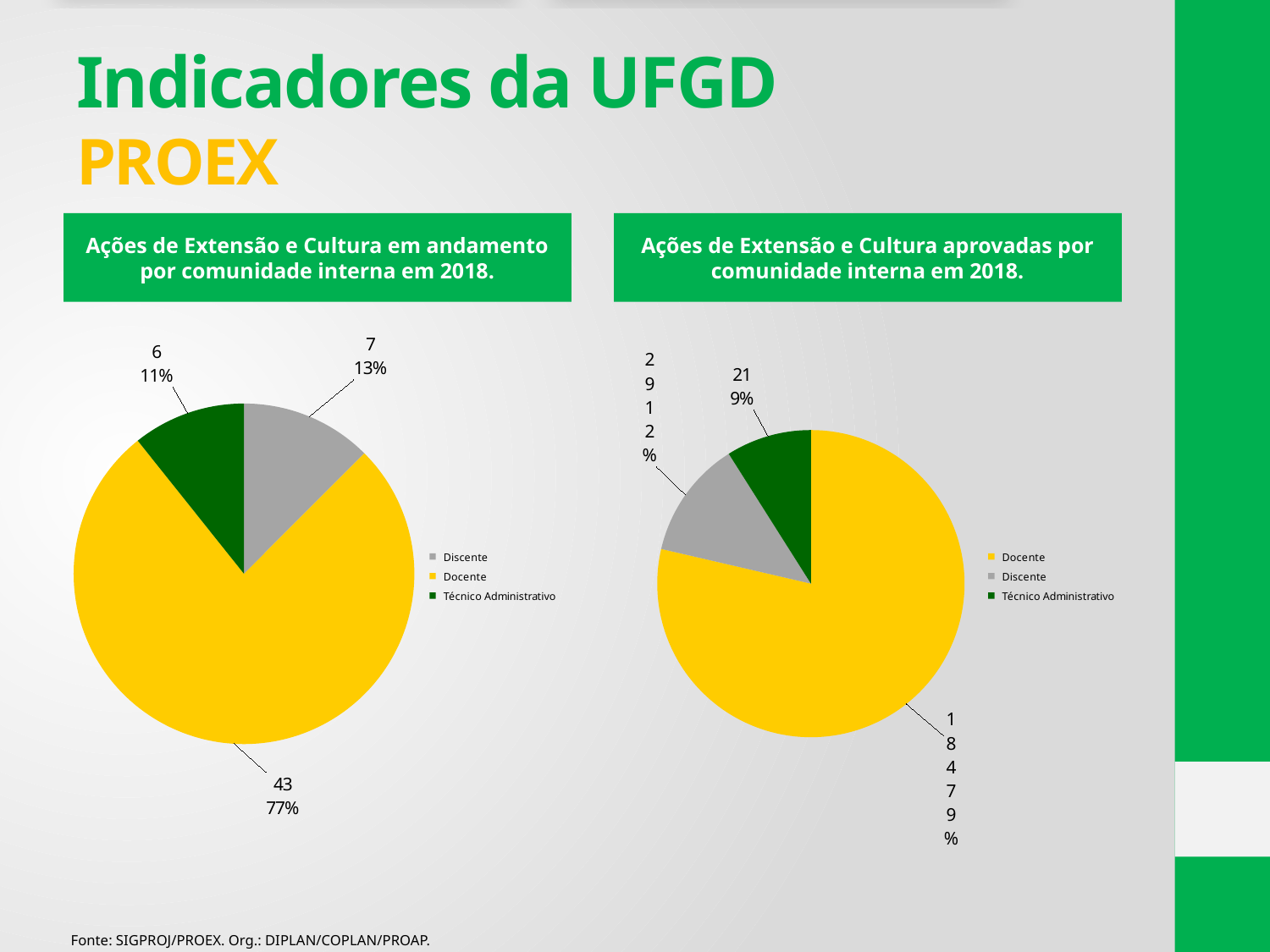
In the left chart (Ações de Extensão e Cultura em andamento), which category has the smallest slice? Técnico Administrativo In the right chart (Ações de Extensão e Cultura aprovadas), which category has the largest slice? Docente How many categories does the legend of the right chart (Ações de Extensão e Cultura aprovadas) list? 3 In the left chart (Ações de Extensão e Cultura em andamento), what is the difference between the Docente value and the Discente value? 36 What type of chart is used on the left side of the slide? Pie chart In the left chart (Ações de Extensão e Cultura em andamento), what is the value for Docente? 43 In the right chart (Ações de Extensão e Cultura aprovadas), what percentage share does Técnico Administrativo have? 9% In the right chart (Ações de Extensão e Cultura aprovadas), what is the value for Técnico Administrativo? 21 In the left chart (Ações de Extensão e Cultura em andamento), what is the value for Técnico Administrativo? 6 In the right chart (Ações de Extensão e Cultura aprovadas), which is larger, Discente or Técnico Administrativo? Discente In the left chart (Ações de Extensão e Cultura em andamento), which category has the largest slice? Docente In the left chart (Ações de Extensão e Cultura em andamento), what percentage share does Discente have? 13%